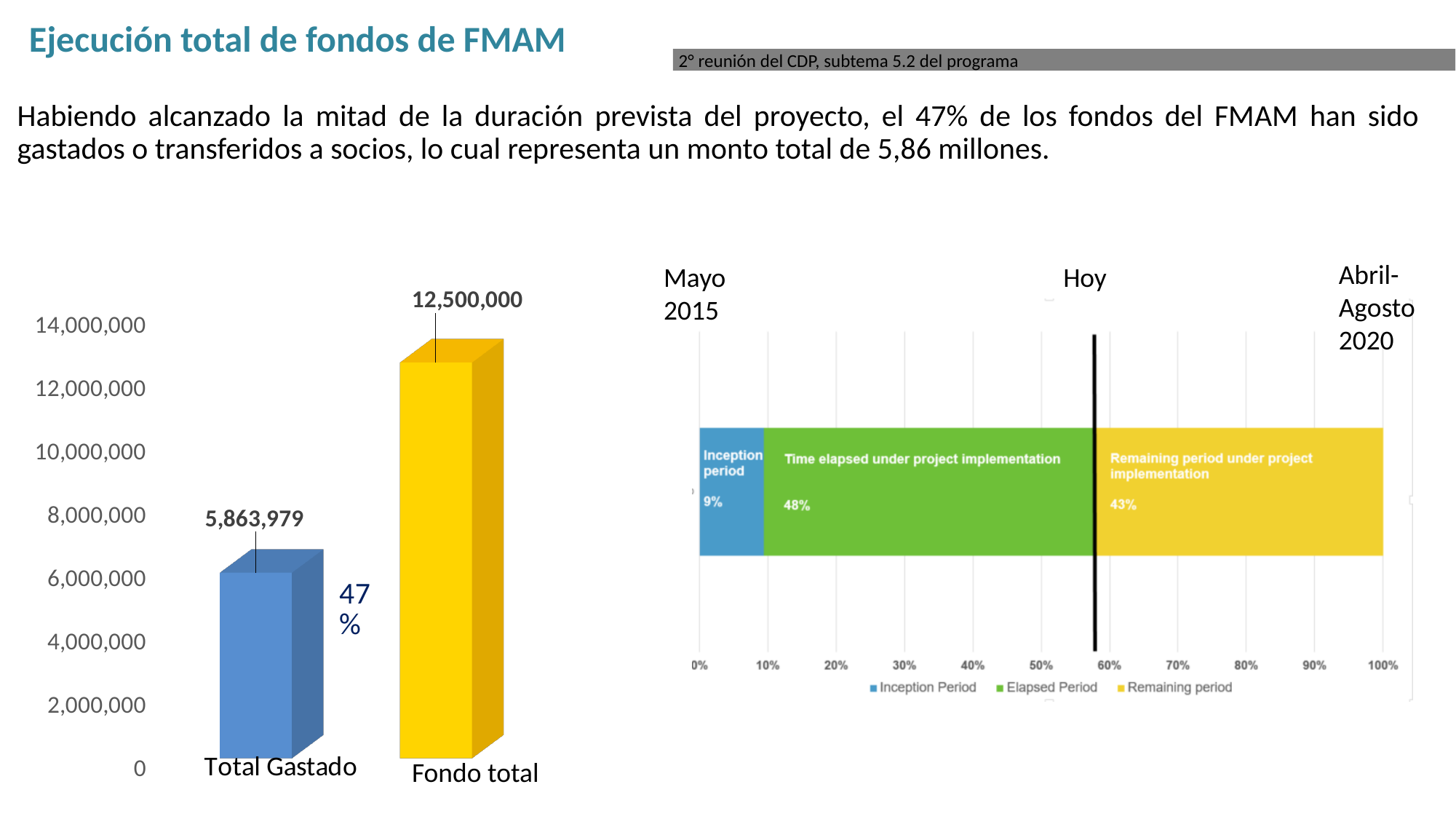
What kind of chart is the chart on the left? bar chart In the bar chart on the left, what is the value for Total Gastado? 5,863,979 In the stacked bar chart on the right, what percentage is shown for the Inception period? 9% In the bar chart on the left, what is the difference between Fondo total and Total Gastado? 6,636,021 In the bar chart on the left, what is the value for Fondo total? 12,500,000 In the stacked bar chart on the right, what percentage is shown for Remaining period under project implementation? 43% In the bar chart on the left, is the value for Total Gastado greater or less than 6,000,000? less In the bar chart on the left, how many categories are shown? 2 In the stacked bar chart on the right, which segment is the smallest? Inception period In the stacked bar chart on the right, what percentage is shown for Time elapsed under project implementation? 48% In the bar chart on the left, which category has the higher value? Fondo total In the stacked bar chart on the right, how many series does the legend list? 3